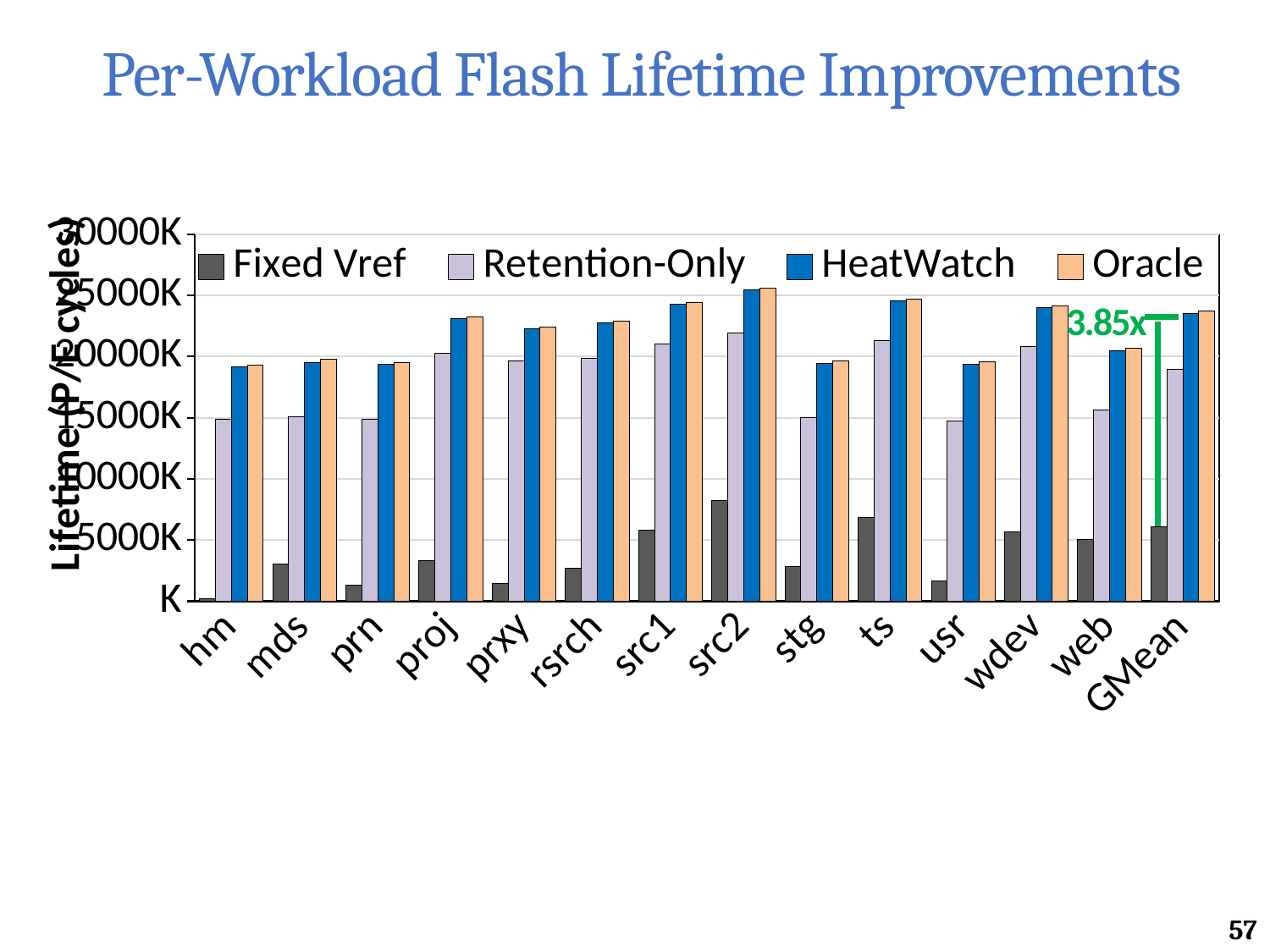
What kind of chart is shown on the slide? bar chart How many workload categories are shown along the x axis? 14 Is the Fixed Vref value for src2 greater or less than 5000K? greater Is the Fixed Vref value for ts greater or less than 5000K? greater Which workload has the lowest Fixed Vref bar? hm Which workload has the highest Fixed Vref bar? src2 Which series is drawn in dark gray in the legend? Fixed Vref What improvement factor is annotated above the GMean bars? 3.85x How many series does the legend list? 4 Which is larger, the Retention-Only value for wdev or for web? wdev Is the Fixed Vref value for mds greater or less than 5000K? less Which is larger, the Retention-Only value for src1 or for stg? src1